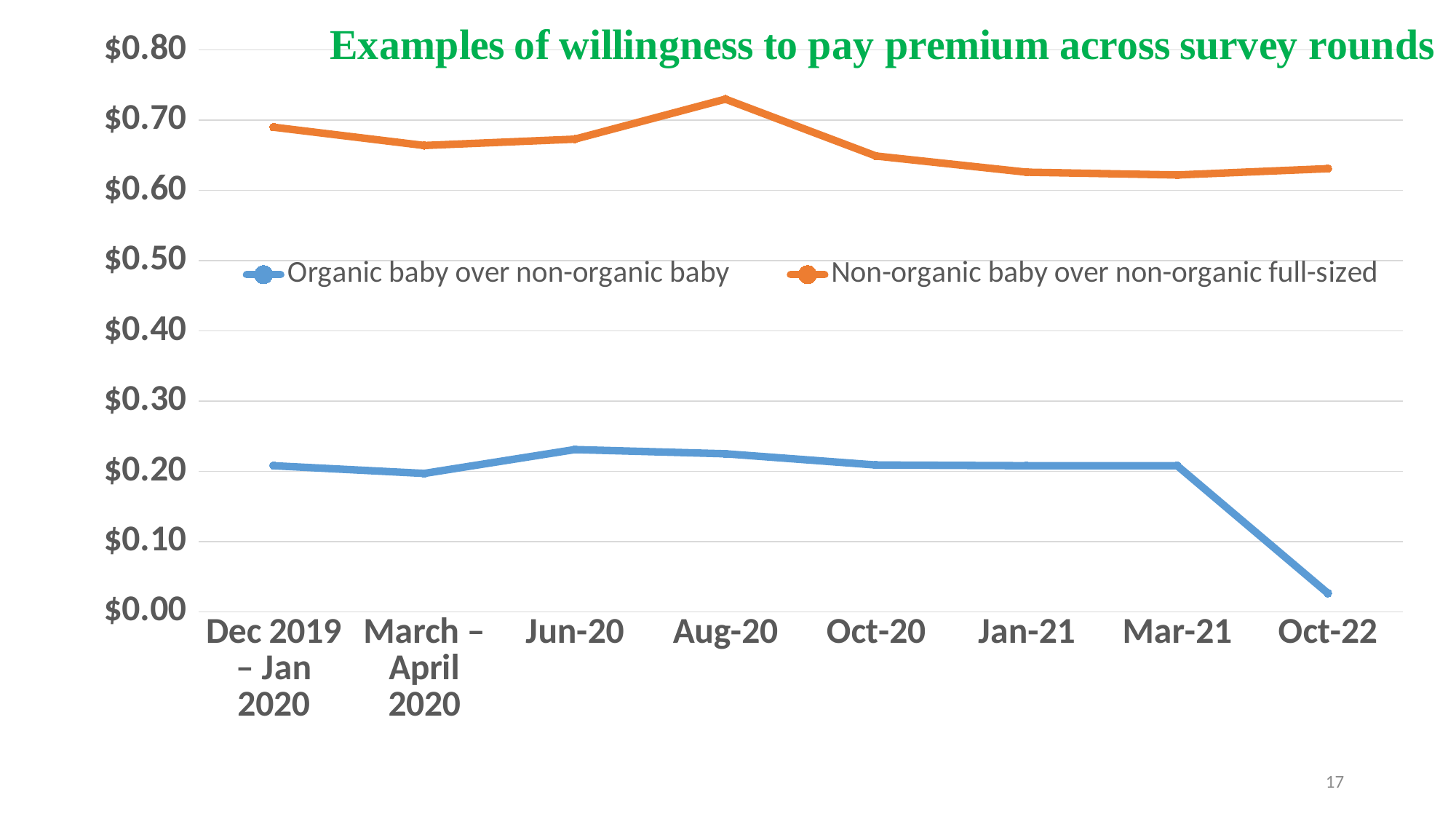
Which is larger for the 'Organic baby over non-organic baby' series: the value in Mar-21 or the value in Oct-22? Mar-21 How many survey rounds are plotted along the x axis? 8 What kind of chart is shown on the slide? line chart Is the value for 'Non-organic baby over non-organic full-sized' in Aug-20 greater or less than $0.70? greater Which survey round has the lowest value for the 'Organic baby over non-organic baby' series? Oct-22 What colour is the line for the 'Non-organic baby over non-organic full-sized' series? orange Is the value for 'Organic baby over non-organic baby' in Oct-22 greater or less than $0.10? less Which survey round has the highest value for the 'Non-organic baby over non-organic full-sized' series? Aug-20 How many series does the legend list? 2 In Jun-20, which series has the larger value: 'Organic baby over non-organic baby' or 'Non-organic baby over non-organic full-sized'? Non-organic baby over non-organic full-sized Is the value for 'Non-organic baby over non-organic full-sized' in Oct-20 greater or less than $0.70? less Does the 'Organic baby over non-organic baby' series rise or fall from Mar-21 to Oct-22? fall